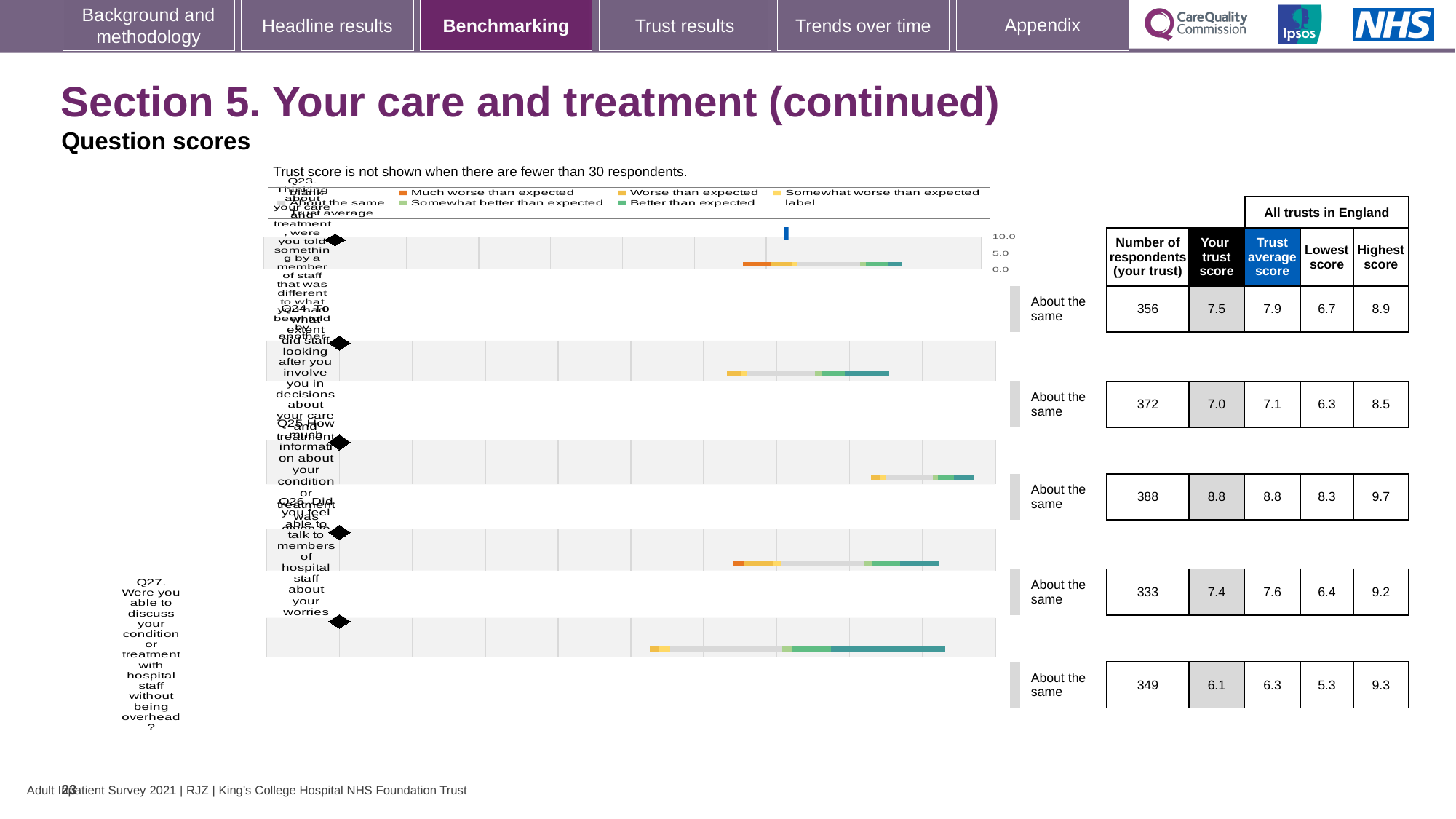
For Q26, which is larger: your trust score or the trust average score? Trust average score What is the 'Your trust score' for Q23 shown in the table? 7.5 For Q23, what is the difference between the trust average score and your trust score? 0.4 In the table next to the chart, how many respondents does Q27 have for your trust? 349 Which question has the largest number of respondents for your trust? Q25 How many questions (rows) are plotted in the benchmarking chart? 5 What is the trust average score for Q25 in the table? 8.8 Which question has the lowest 'Your trust score' in the table? Q27 What is the lowest score across all trusts in England for Q24? 6.3 What benchmark category is shown for Q26? About the same Which question has the highest 'Your trust score' in the table? Q25 What is the highest score across all trusts in England for Q27? 9.3